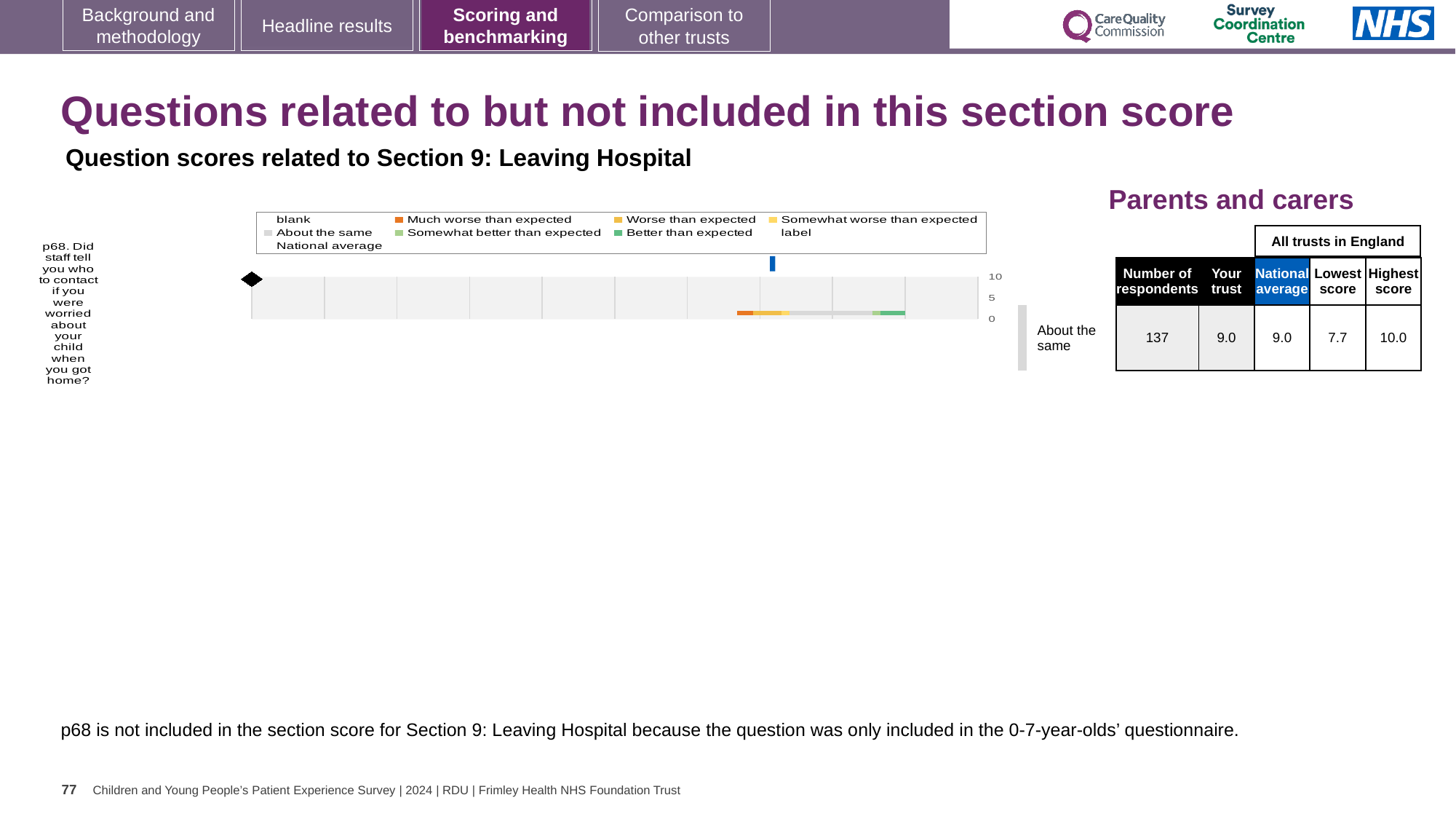
How many questions are plotted in the chart? 1 Which legend entry is shown in orange? Much worse than expected What is the difference between the highest score and the lowest score for p68? 2.3 What is the 'Your trust' score for p68? 9.0 How many entries does the chart legend list? 9 What is the lowest score among all trusts in England for p68? 7.7 What is the national average score for p68? 9.0 How many respondents answered p68? 137 What benchmark category is the trust's p68 result labelled as? About the same Is the 'Your trust' score for p68 higher than, lower than, or the same as the national average? the same What kind of chart is used to show the p68 benchmarking result? bar chart What is the highest score among all trusts in England for p68? 10.0